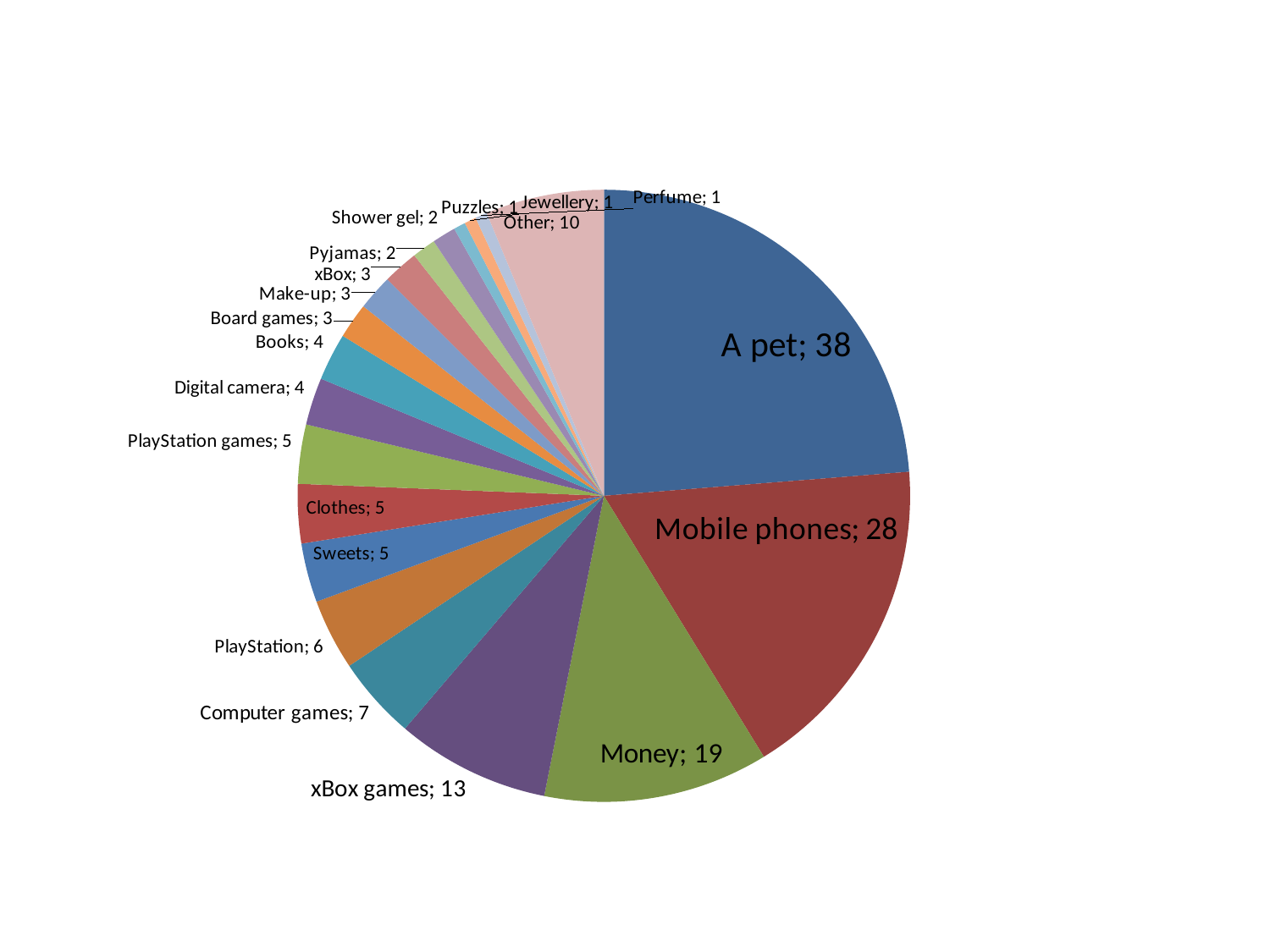
Which is larger, the value for PlayStation or the value for Digital camera? PlayStation What is the difference between the values for A pet and Mobile phones? 10 Which category has the largest slice of the pie? A pet What is the difference between the values for Money and xBox games? 6 What is the value for Computer games? 7 What is the value for Other? 10 What is the value for A pet? 38 What is the value for xBox games? 13 What type of chart is shown on the slide? Pie chart How many categories (slices) does the pie chart have? 20 What share of the pie does Mobile phones represent? 17.5% What is the value for Mobile phones? 28